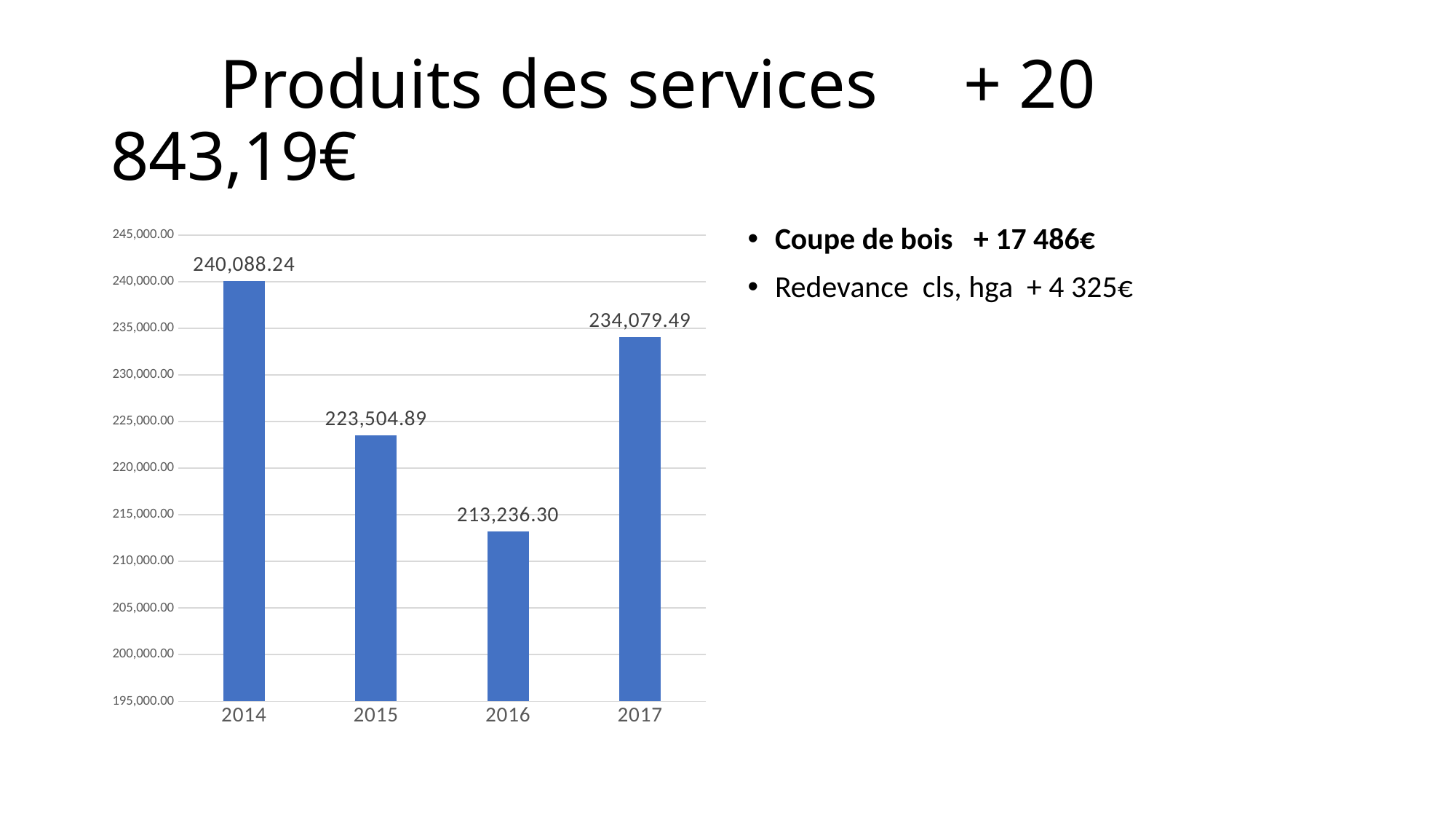
How many years are shown on the x axis? 4 Do the values rise or fall from 2014 to 2016? fall What kind of chart is shown on the slide? bar chart Which is larger, the value for 2015 or the value for 2017? 2017 What is the difference between the values for 2017 and 2016? 20,843.19 Which year has the highest value? 2014 What is the value for 2016? 213,236.30 What is the value for 2014? 240,088.24 Which year has the lowest value? 2016 What is the difference between the values for 2014 and 2015? 16,583.35 Is the value for 2015 greater or less than 220,000.00? greater What is the value for 2017? 234,079.49